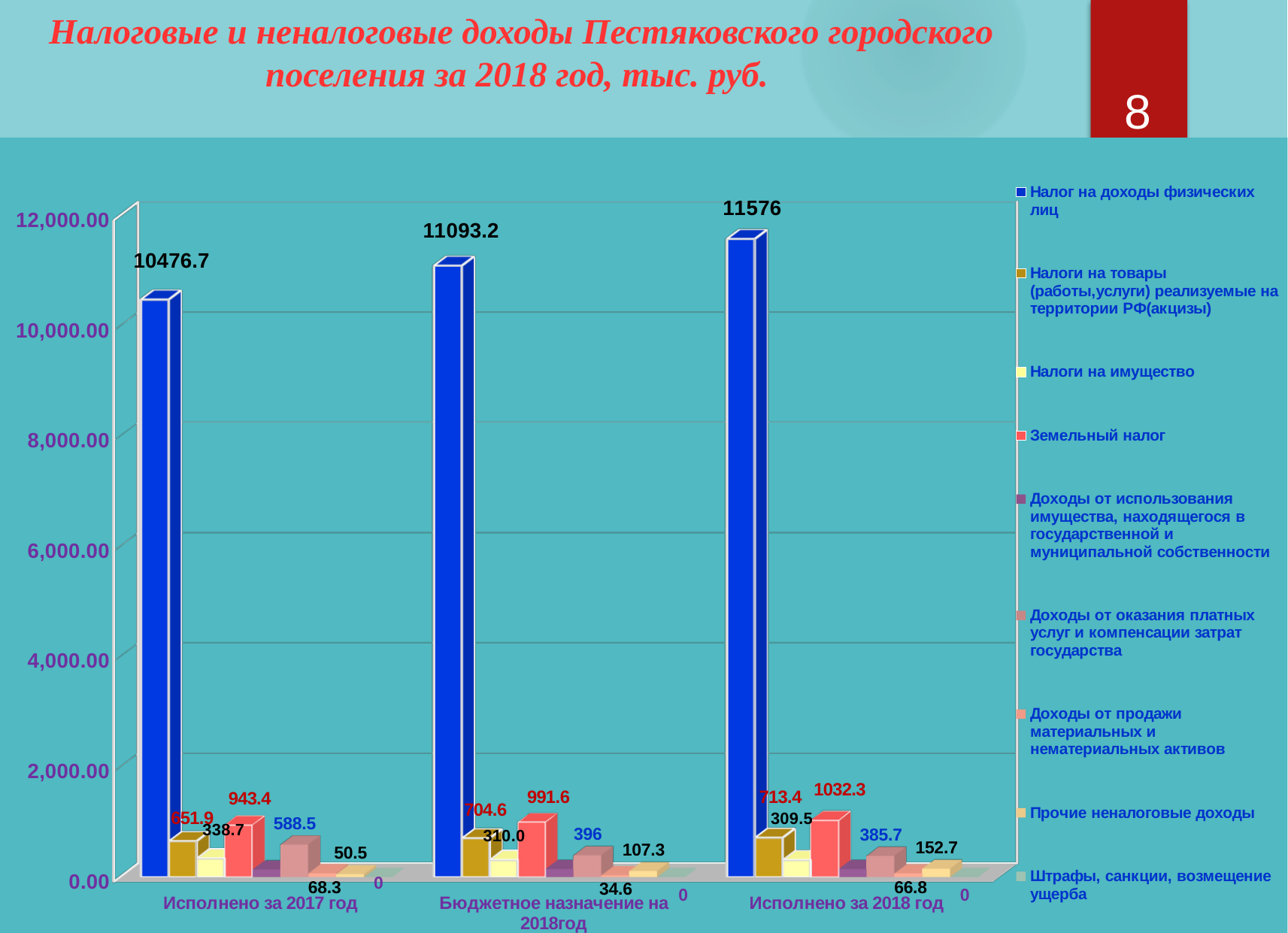
Which is larger: "Налог на доходы физических лиц" for "Исполнено за 2018 год" or for "Бюджетное назначение на 2018год"? Исполнено за 2018 год What is the value of "Налог на доходы физических лиц" for "Исполнено за 2018 год"? 11576 What is the difference between the "Налог на доходы физических лиц" values for "Исполнено за 2018 год" and "Исполнено за 2017 год"? 1099.3 What type of chart is shown on the slide? Bar chart Which category has the lowest value for "Налог на доходы физических лиц"? Исполнено за 2017 год How many series does the legend list? 9 What is the value of "Земельный налог" for "Исполнено за 2018 год"? 1032.3 How many categories are shown on the x axis? 3 What is the value of "Налог на доходы физических лиц" for "Исполнено за 2017 год"? 10476.7 Does the value of "Налог на доходы физических лиц" rise or fall across the categories from left to right? Rises Which category has the highest value for "Налог на доходы физических лиц"? Исполнено за 2018 год What is the value of "Налог на доходы физических лиц" for "Бюджетное назначение на 2018год"? 11093.2